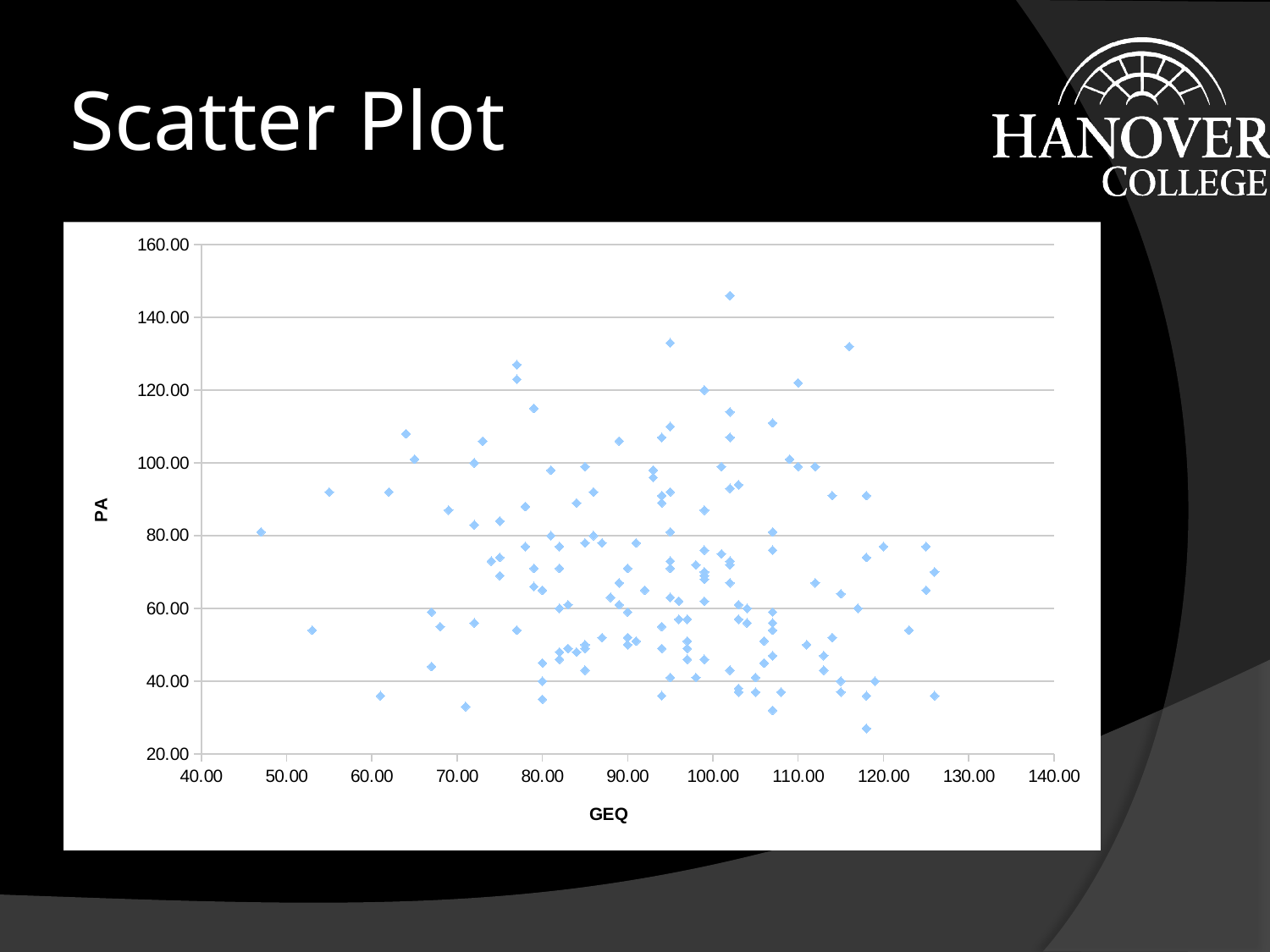
What is the minimum value shown on the y axis of the chart? 20.00 Is the GEQ value of the rightmost point on the chart greater or less than 130? less What is the maximum value shown on the y axis of the chart? 160.00 What is the label of the x axis of the chart? GEQ Is the lowest PA value plotted on the chart greater or less than 40? less Is the GEQ value of the leftmost point on the chart greater or less than 50? less What is the minimum value shown on the x axis of the chart? 40.00 What kind of chart is shown on the slide? Scatter plot What is the label of the y axis of the chart? PA What is the maximum value shown on the x axis of the chart? 140.00